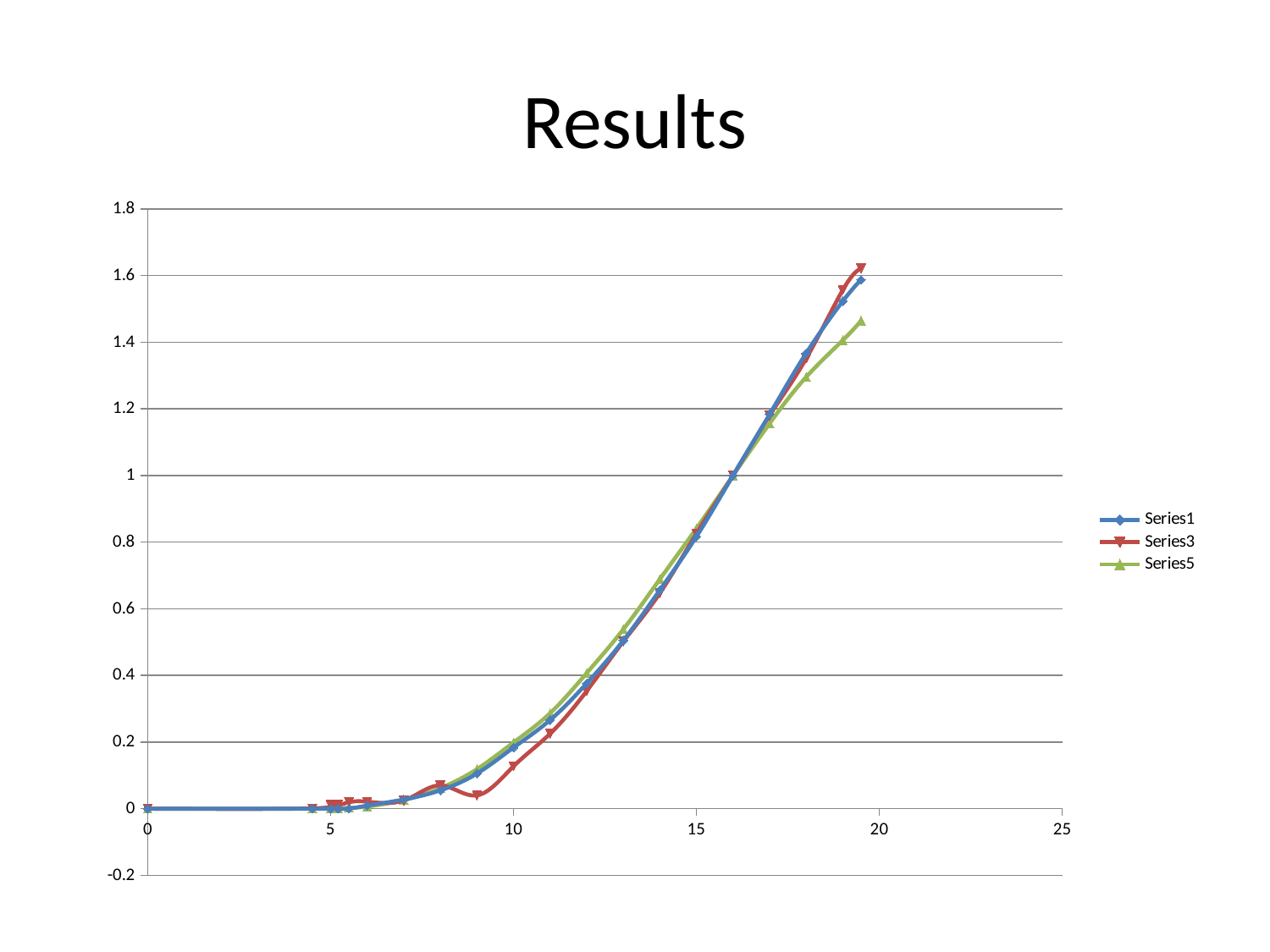
Is the value of Series1 at x = 10 greater or less than 0.4? less Which colour is used for Series3 in the chart? red What kind of chart is shown on the slide? line chart Do the values of Series1 rise or fall as x increases from 10 to 20? rise At the right end of the chart (around x = 19.5), which is larger: Series1 or Series5? Series1 Is the value of Series5 at x = 18 greater or less than 1.2? greater Which series has the highest value at the right end of the chart (around x = 19.5)? Series3 Is the value of Series5 at its last point (around x = 19.5) greater or less than 1.2? greater What is the title of the slide/chart? Results How many series does the legend list? 3 Which series has the lowest value at the right end of the chart (around x = 19.5)? Series5